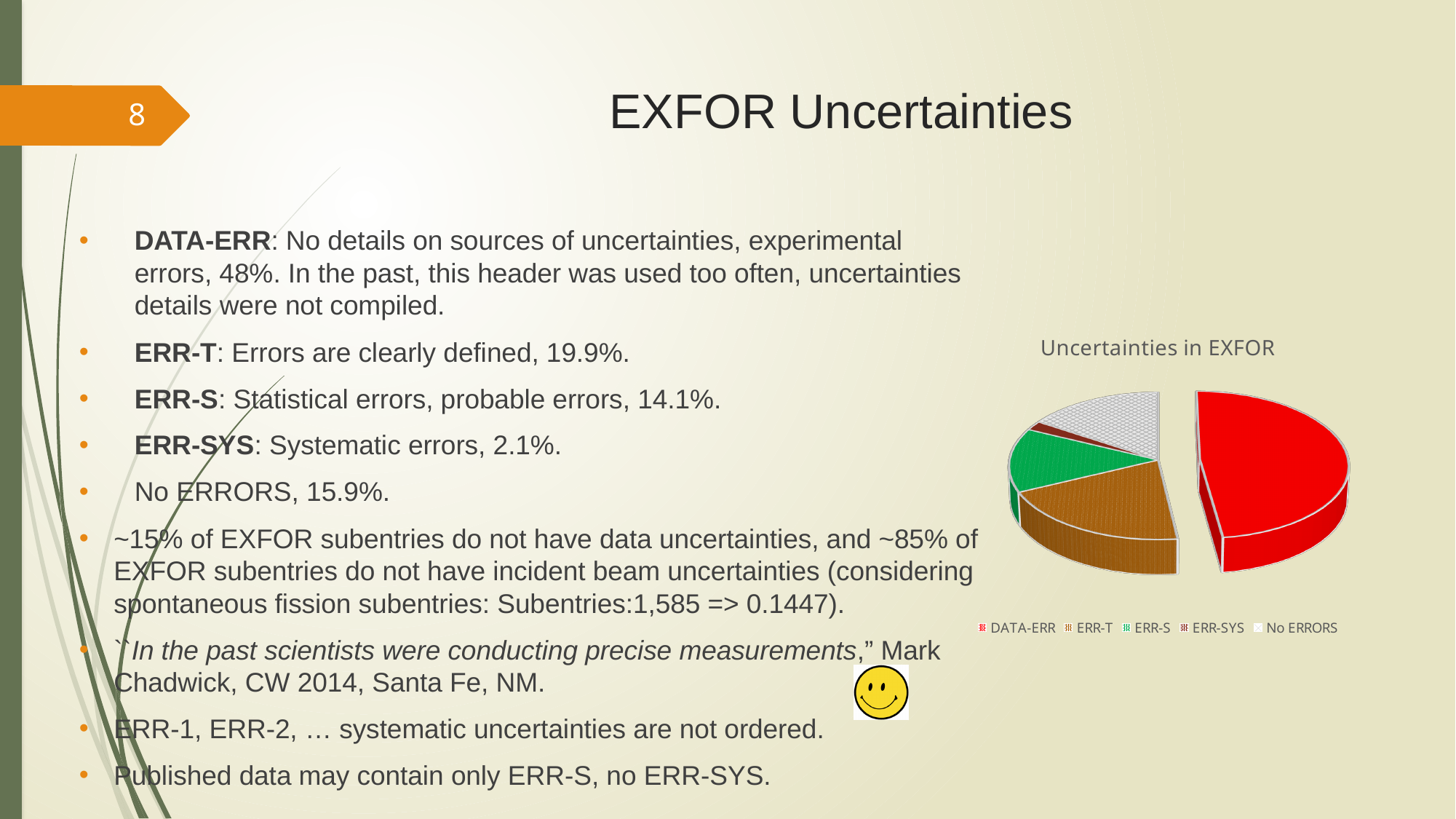
Which category has the smallest slice in the pie chart? ERR-SYS Which category has the largest slice in the pie chart? DATA-ERR Which slice is larger in the pie chart, ERR-T or ERR-S? ERR-T Which slice is larger in the pie chart, DATA-ERR or ERR-T? DATA-ERR Which slice is larger in the pie chart, ERR-T or ERR-SYS? ERR-T How many entries does the legend of the pie chart list? 5 Which slice of the pie chart is pulled out (exploded) from the rest? DATA-ERR What kind of chart is shown on the slide? pie chart How many slices does the pie chart have? 5 According to the slide, what share of EXFOR uncertainties is DATA-ERR? 48% According to the slide, what share of EXFOR uncertainties is ERR-SYS? 2.1% What is the title of the chart on the slide? Uncertainties in EXFOR